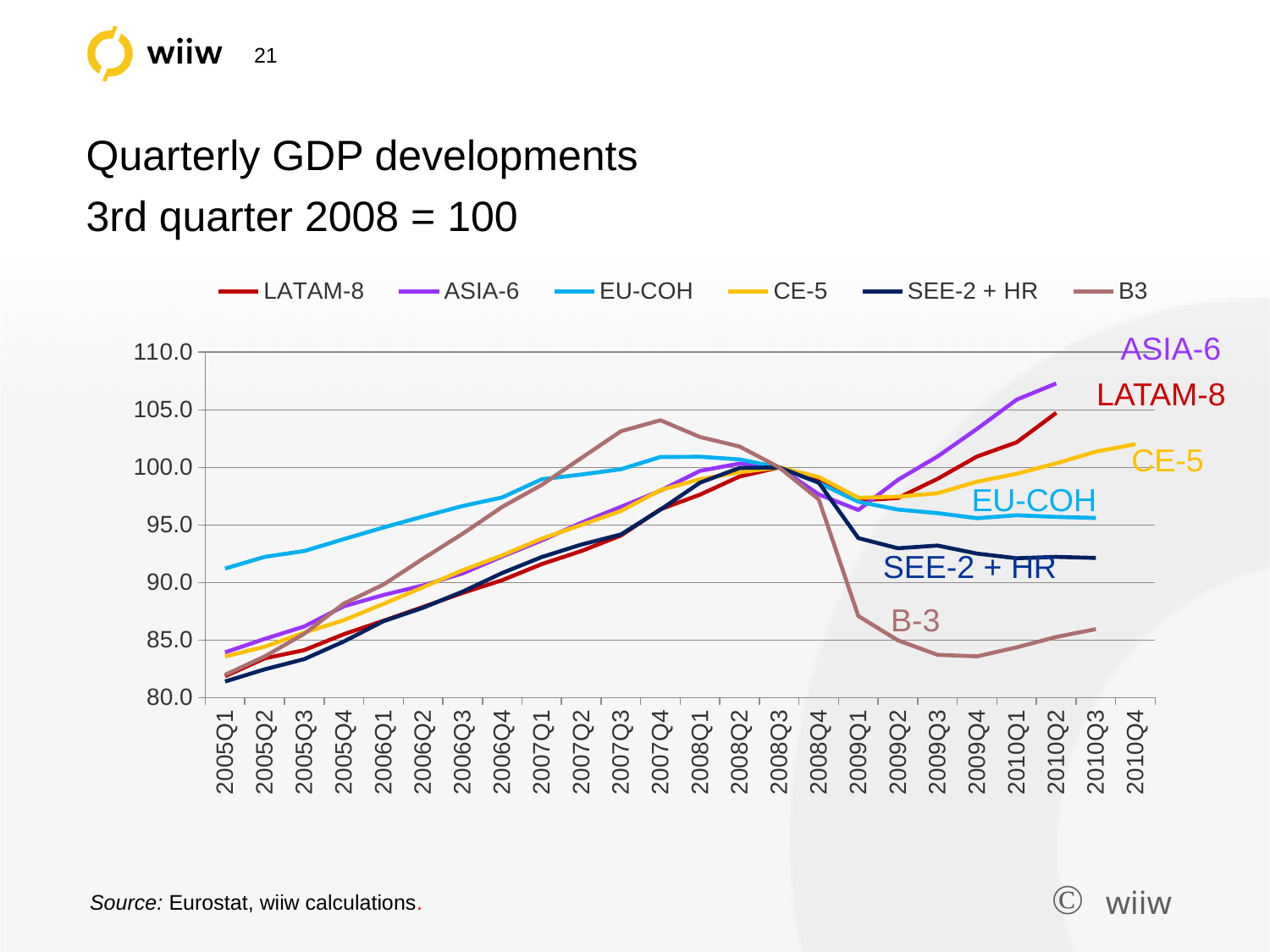
How many series does the legend list? 6 Is the value for B3 in 2009Q3 greater or less than 85? less What is the title of the chart? Quarterly GDP developments 3rd quarter 2008 = 100 What kind of chart is shown on the slide? line chart Which series has the lowest value in 2010Q3? B3 How many quarters are shown on the x axis? 24 Which series has the highest value in 2010Q2? ASIA-6 Does the B3 line rise or fall from 2008Q3 to 2009Q4? fall Is the value for SEE-2 + HR in 2010Q3 greater or less than 95? less Is the value for ASIA-6 in 2010Q2 greater or less than 105? greater In 2009Q3, which is higher, B3 or SEE-2 + HR? SEE-2 + HR